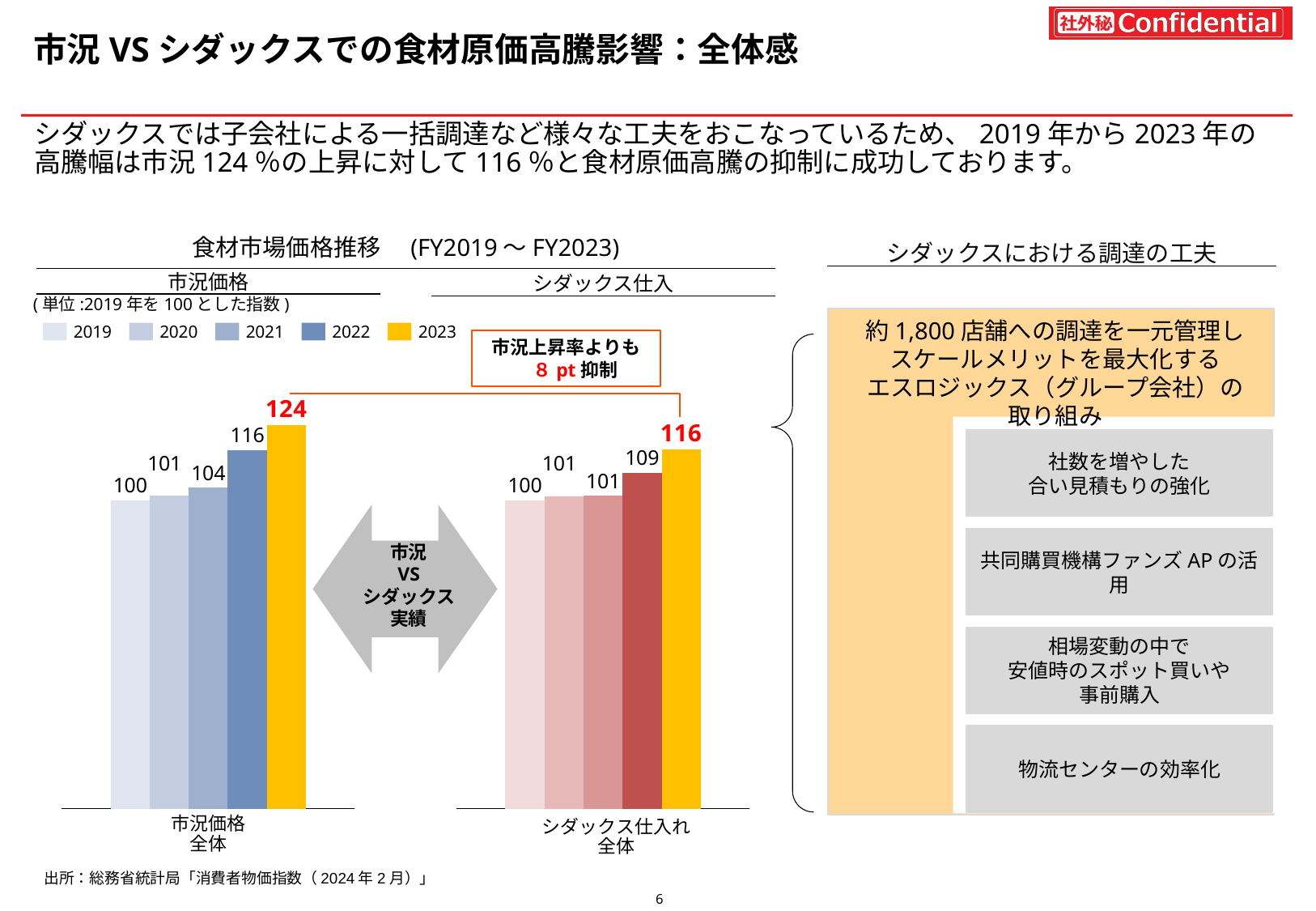
In the 市況価格 chart on the left, which year has the highest value? 2023 Which is larger: the 2022 value in the 市況価格 chart or the 2022 value in the シダックス仕入れ chart? 市況価格 (116) In the シダックス仕入れ chart on the right, which year has the lowest value? 2019 In the シダックス仕入れ chart on the right, what is the value for 2023? 116 In the シダックス仕入れ chart on the right, what is the value for 2021? 101 What kind of chart is used to show the 市況価格 and シダックス仕入れ data? Bar chart In the シダックス仕入れ chart on the right, do the values rise or fall from 2019 to 2023? Rise In the 市況価格 chart on the left, what is the value for 2023? 124 In the 市況価格 chart on the left, what is the difference between the 2022 and 2021 values? 12 What is the difference between the 2023 value in the 市況価格 chart and the 2023 value in the シダックス仕入れ chart? 8 In the 市況価格 chart on the left, what is the value for 2022? 116 How many series does the legend list for the charts? 5